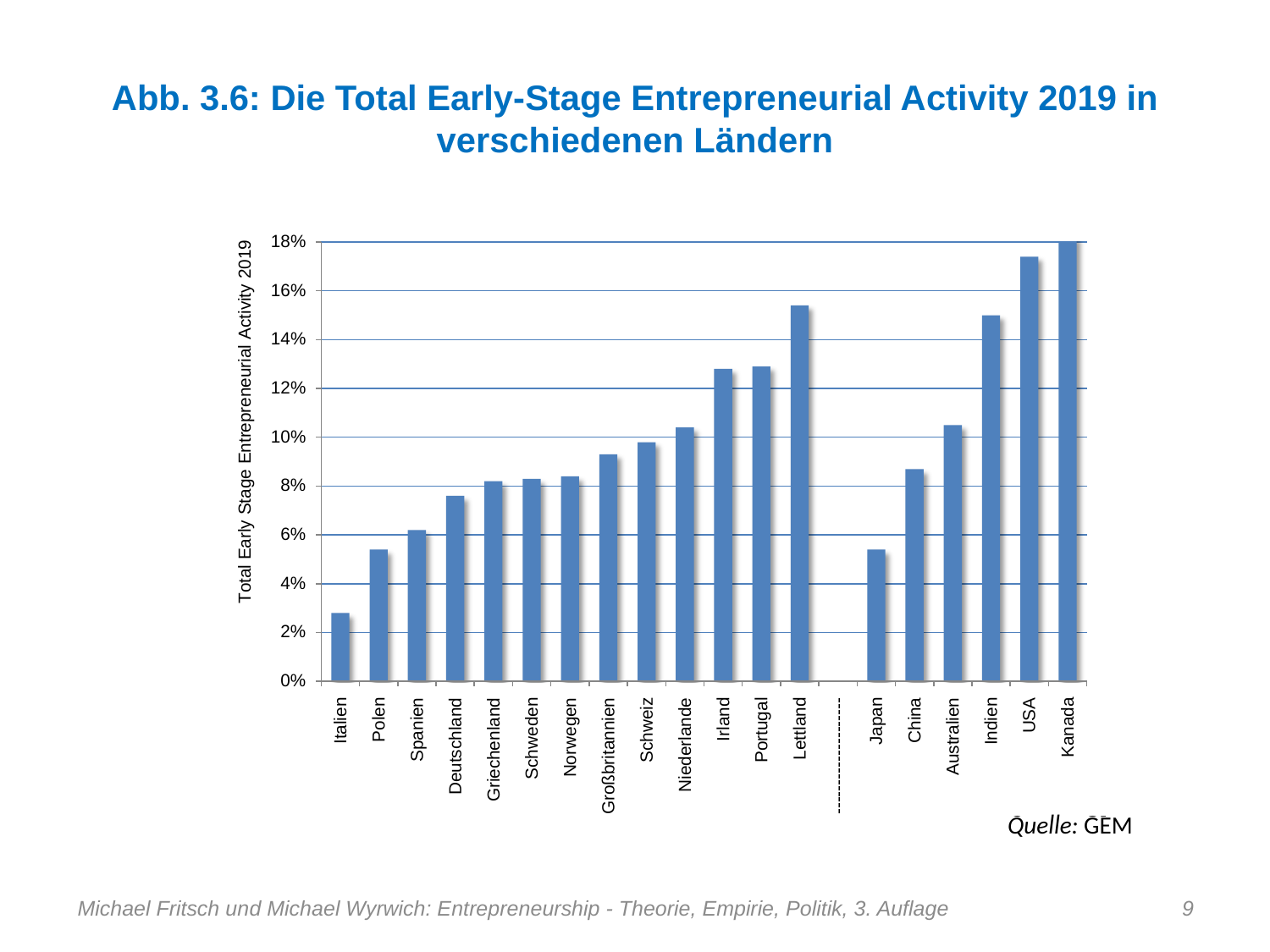
Which has the higher value, Lettland or Portugal? Lettland Which country has the highest Total Early-Stage Entrepreneurial Activity in the chart? Kanada Is the value for Deutschland greater or less than 8%? less How many countries are shown in the chart? 19 What kind of chart is shown on the slide? bar chart Is the value for Irland greater or less than 12%? greater Which country has the lowest Total Early-Stage Entrepreneurial Activity in the chart? Italien Is the value for Lettland greater or less than 14%? greater Which has the higher value, Indien or USA? USA What is the source given for the chart? GEM